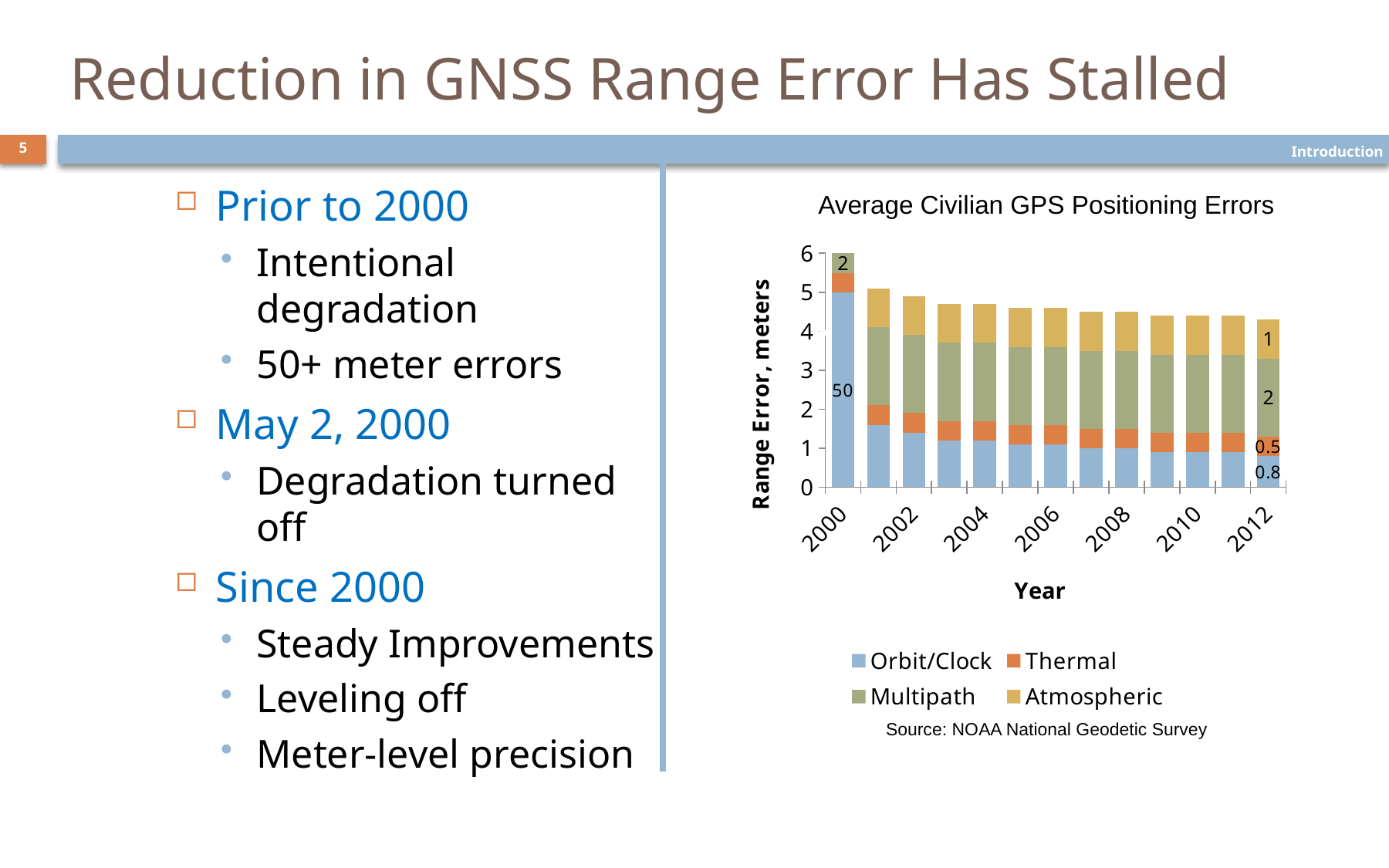
What is the total range error for the 2012 stacked bar? 4.3 What is the Orbit/Clock range error labelled for 2000? 50 What is the Thermal range error for 2012? 0.5 What is the Atmospheric range error for 2012? 1 Do the total range errors rise or fall from 2001 to 2012? fall How many years (bars) are plotted in the chart? 13 In 2012, which is larger, the Multipath error or the Atmospheric error? Multipath What is the title of the chart's vertical axis? Range Error, meters What is the Multipath range error for 2012? 2 What is the Orbit/Clock range error for 2012? 0.8 What kind of chart is shown on the slide? bar chart How many series does the legend of the chart list? 4